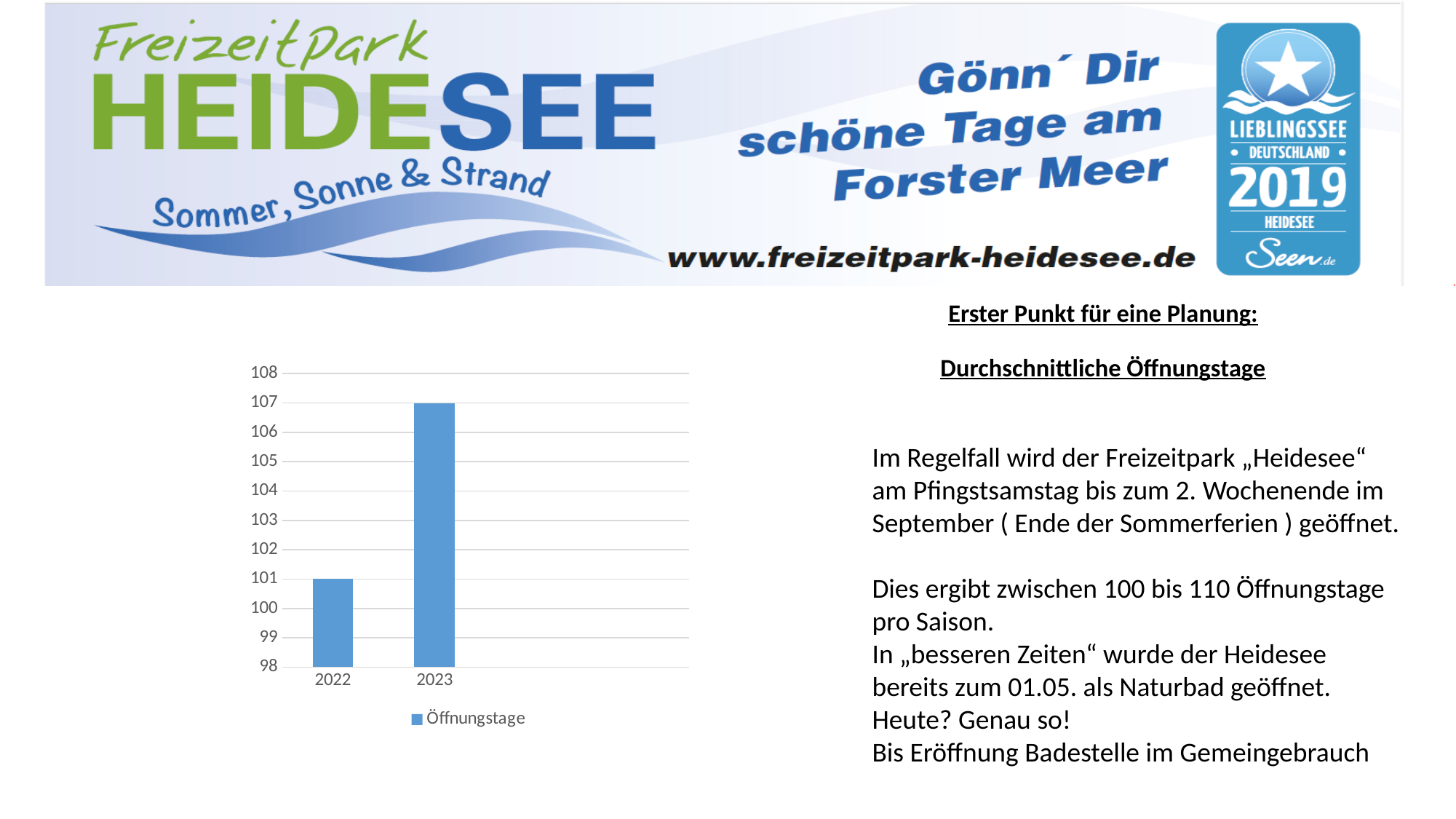
Which year has the lower number of Öffnungstage? 2022 By how much do the Öffnungstage in 2023 exceed those in 2022? 6 Do the Öffnungstage rise or fall from 2022 to 2023? rise How many series does the chart's legend list? 1 What is the value of Öffnungstage for 2023? 107 How many categories (years) are shown on the x axis of the chart? 2 What is the value of Öffnungstage for 2022? 101 Which year has the higher number of Öffnungstage? 2023 What is the name of the series shown in the chart's legend? Öffnungstage Is the value for 2023 greater or less than 105? greater What kind of chart is shown on the slide? bar chart Is the value for 2022 greater or less than 105? less